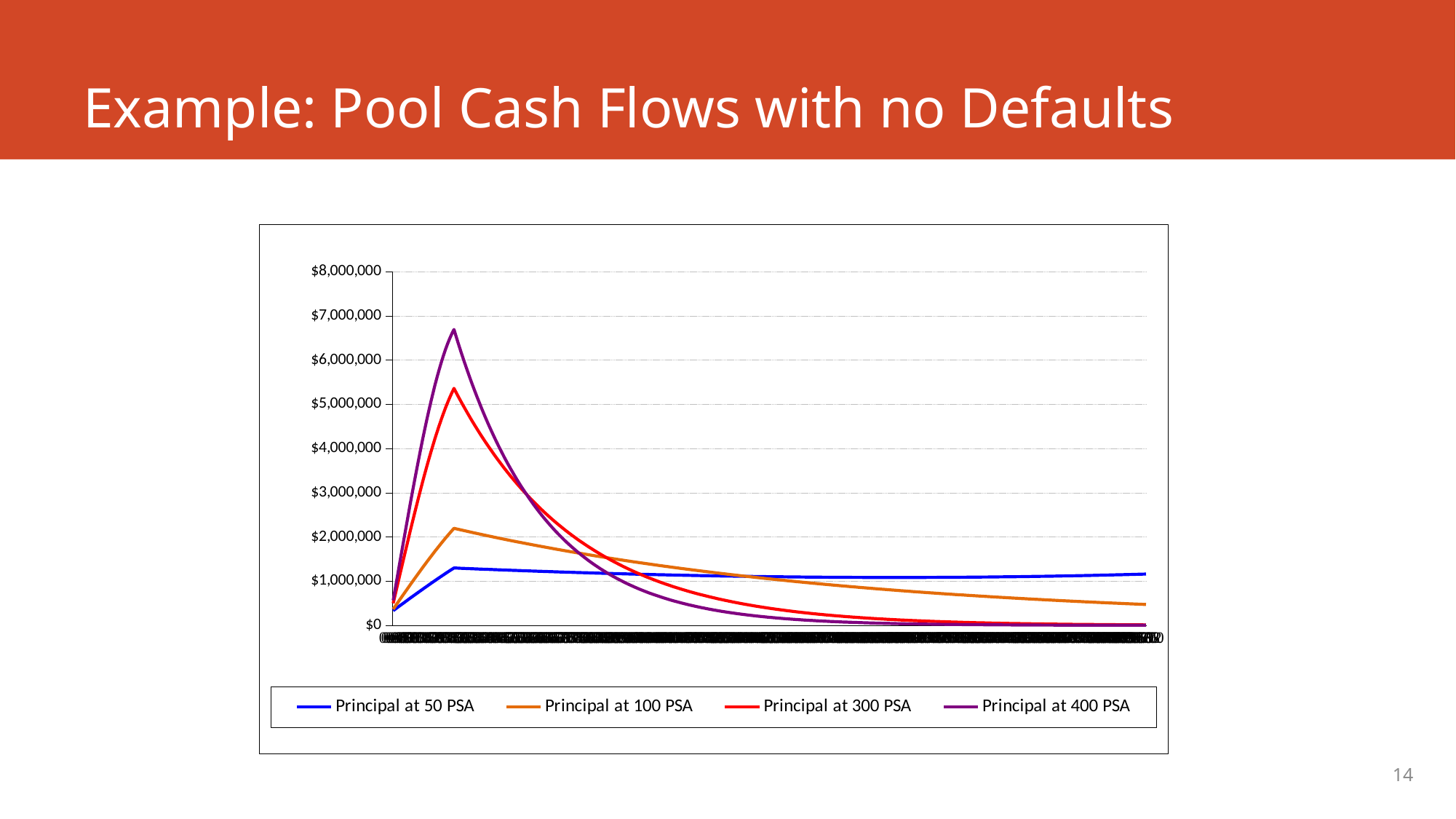
After reaching its peak, does the Principal at 400 PSA line rise or fall along the x axis? fall What kind of chart is shown on the slide? line chart Is the peak value of Principal at 300 PSA greater or less than $5,000,000? greater Which series has the highest value at the right end of the chart? Principal at 50 PSA How many series does the legend list? 4 Which series reaches the highest peak value? Principal at 400 PSA Which series has the lowest peak value? Principal at 50 PSA What colour is the line for Principal at 50 PSA? blue Is the peak value of Principal at 50 PSA greater or less than $2,000,000? less Is the peak value of Principal at 100 PSA greater or less than $3,000,000? less Which series has the larger peak value, Principal at 300 PSA or Principal at 100 PSA? Principal at 300 PSA